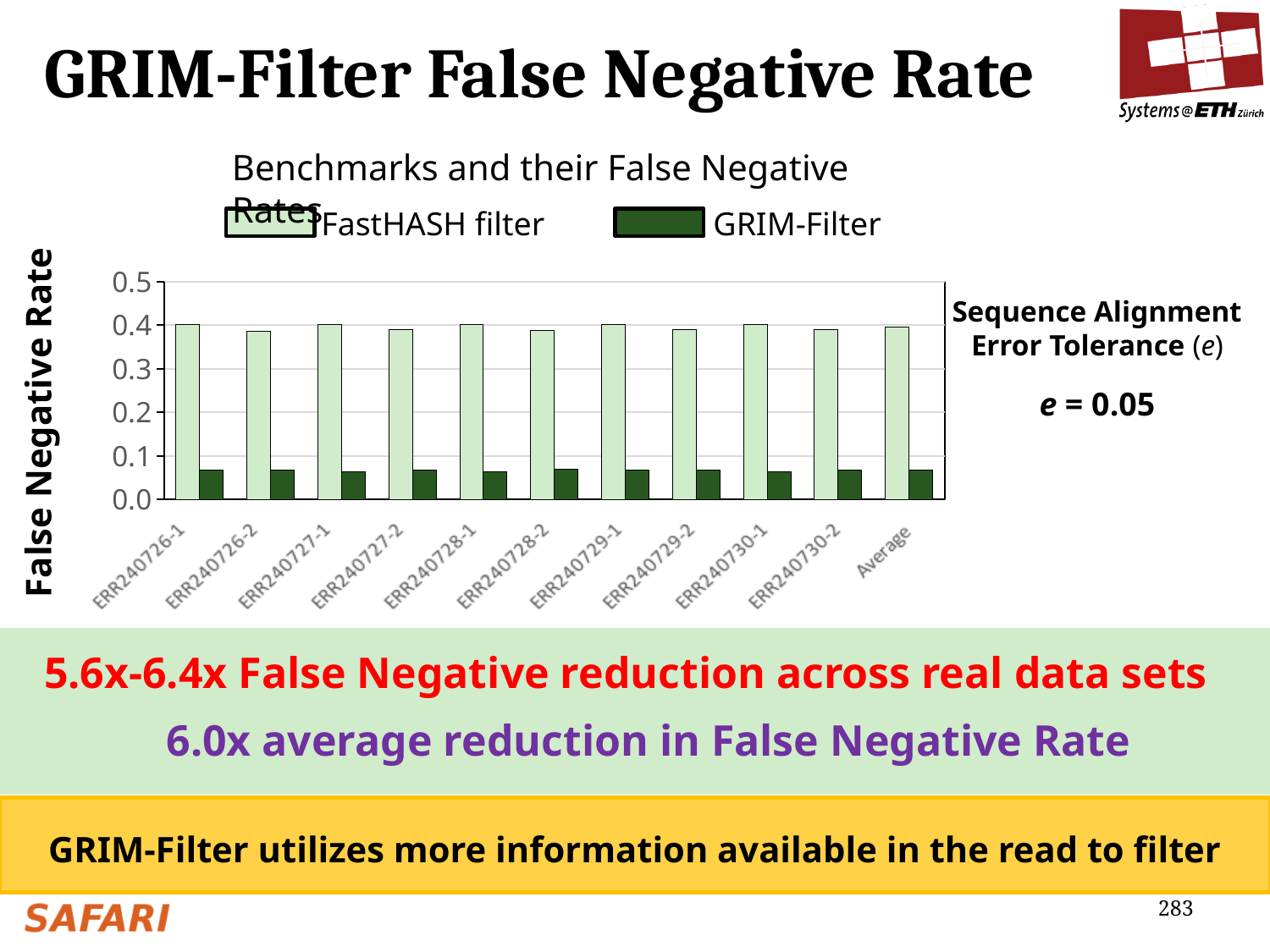
How many categories are shown along the x axis of the chart? 11 What kind of chart is shown on the slide? bar chart Is the FastHASH filter value for ERR240726-1 greater or less than 0.3? greater What is the label of the vertical axis of the chart? False Negative Rate Is the FastHASH filter value for ERR240730-2 greater or less than 0.5? less For Average, which series has the smaller value, FastHASH filter or GRIM-Filter? GRIM-Filter For ERR240729-1, which series has the larger value, FastHASH filter or GRIM-Filter? FastHASH filter Is the GRIM-Filter value for Average greater or less than 0.1? less What is the title of the chart? Benchmarks and their False Negative Rates How many series does the chart legend list? 2 Which series is drawn in dark green in the chart? GRIM-Filter